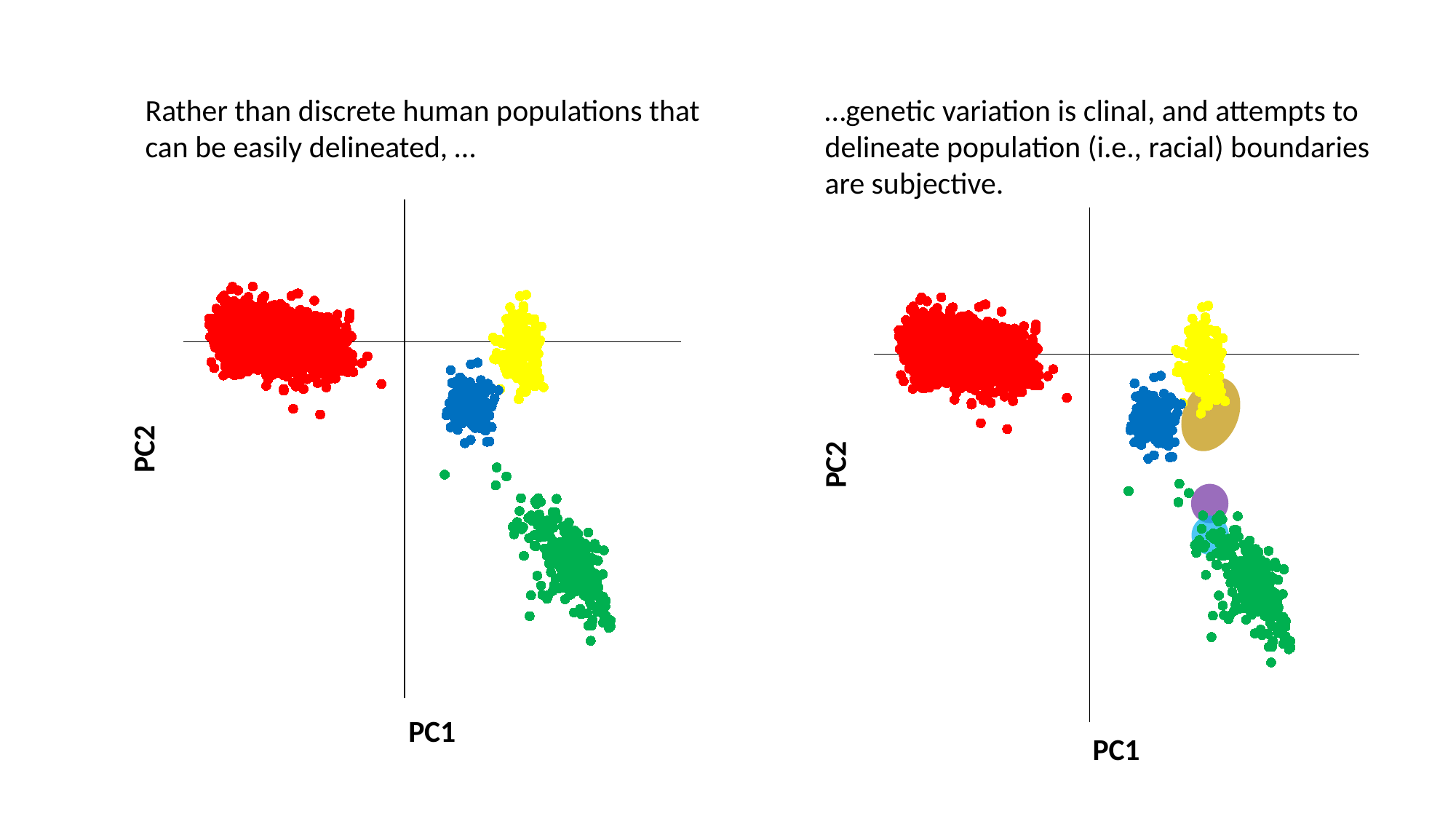
In the left chart, which coloured cluster lies lowest along PC2? green In the left chart, how many differently coloured clusters of points are plotted? 4 In the left chart, is the red cluster to the left or to the right of the vertical PC2 axis line? left In the left chart, which cluster is higher along PC2, the blue cluster or the green cluster? blue In the left chart, which coloured cluster lies furthest to the right along PC1? green In the left chart, is the green cluster above or below the horizontal PC1 axis line? below In the left chart, what is the label of the vertical axis? PC2 In the left chart, which coloured cluster lies furthest to the left along PC1? red In the right chart, which coloured cluster contains the most points? red What kind of chart is shown on the left side of the slide? scatter chart In the right chart, which coloured cluster is the purple circle placed next to? green In the left chart, what is the label of the horizontal axis? PC1